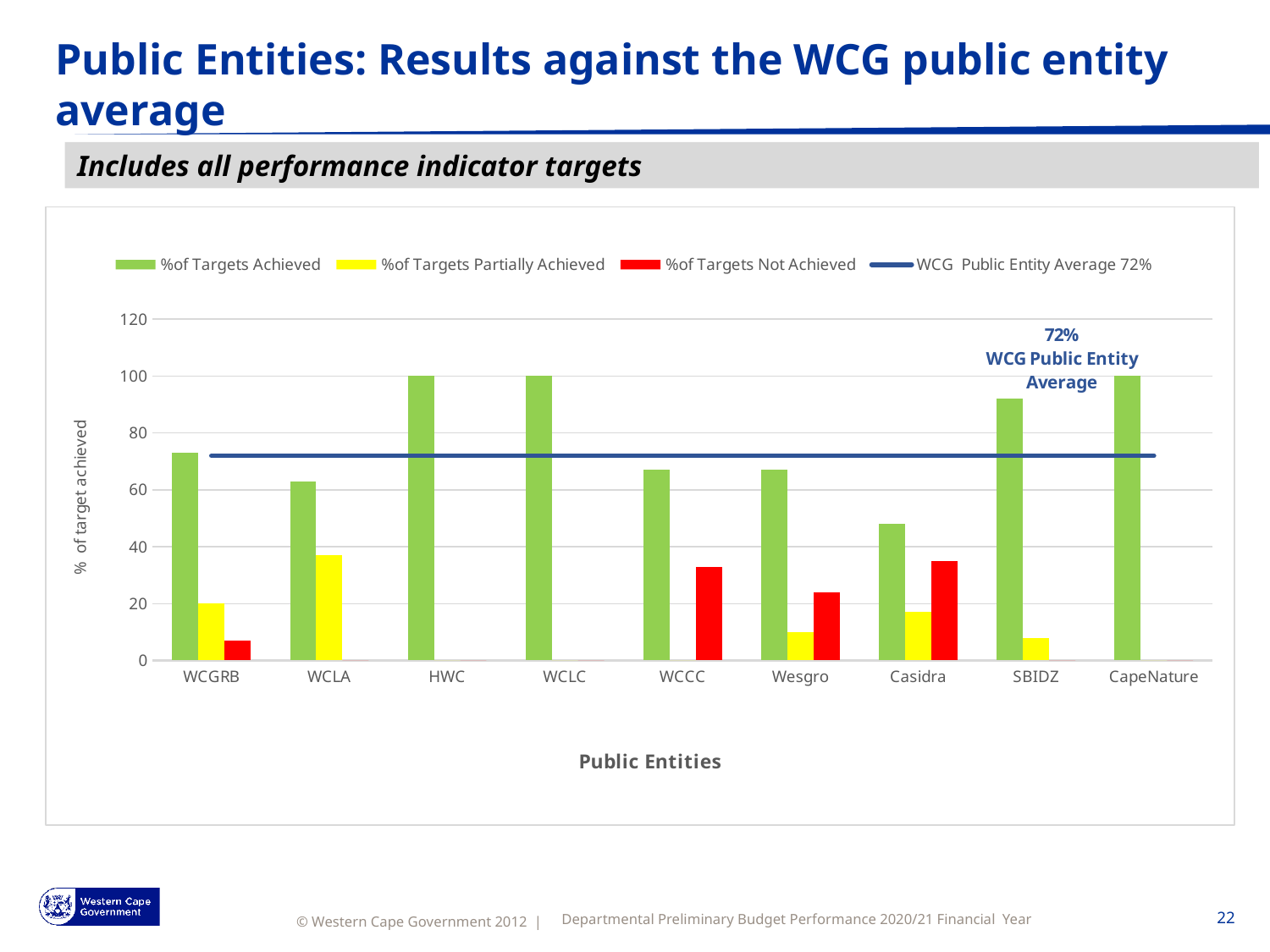
Which has a higher % of Targets Not Achieved, Casidra or Wesgro? Casidra What is the WCG Public Entity Average shown by the horizontal line on the chart? 72% What is the % of Targets Achieved for CapeNature? 100 Is the % of Targets Achieved for Casidra greater or less than 60? less Which public entity has the lowest % of Targets Achieved? Casidra Is the % of Targets Achieved for SBIDZ greater or less than 80? greater What is the % of Targets Achieved for HWC? 100 Which has a higher % of Targets Partially Achieved, WCLA or WCGRB? WCLA How many entries does the chart legend list? 4 What kind of chart is shown on the slide? Combination bar and line chart Is the % of Targets Not Achieved for WCCC greater or less than 20? greater How many public entities are shown on the x axis of the chart? 9